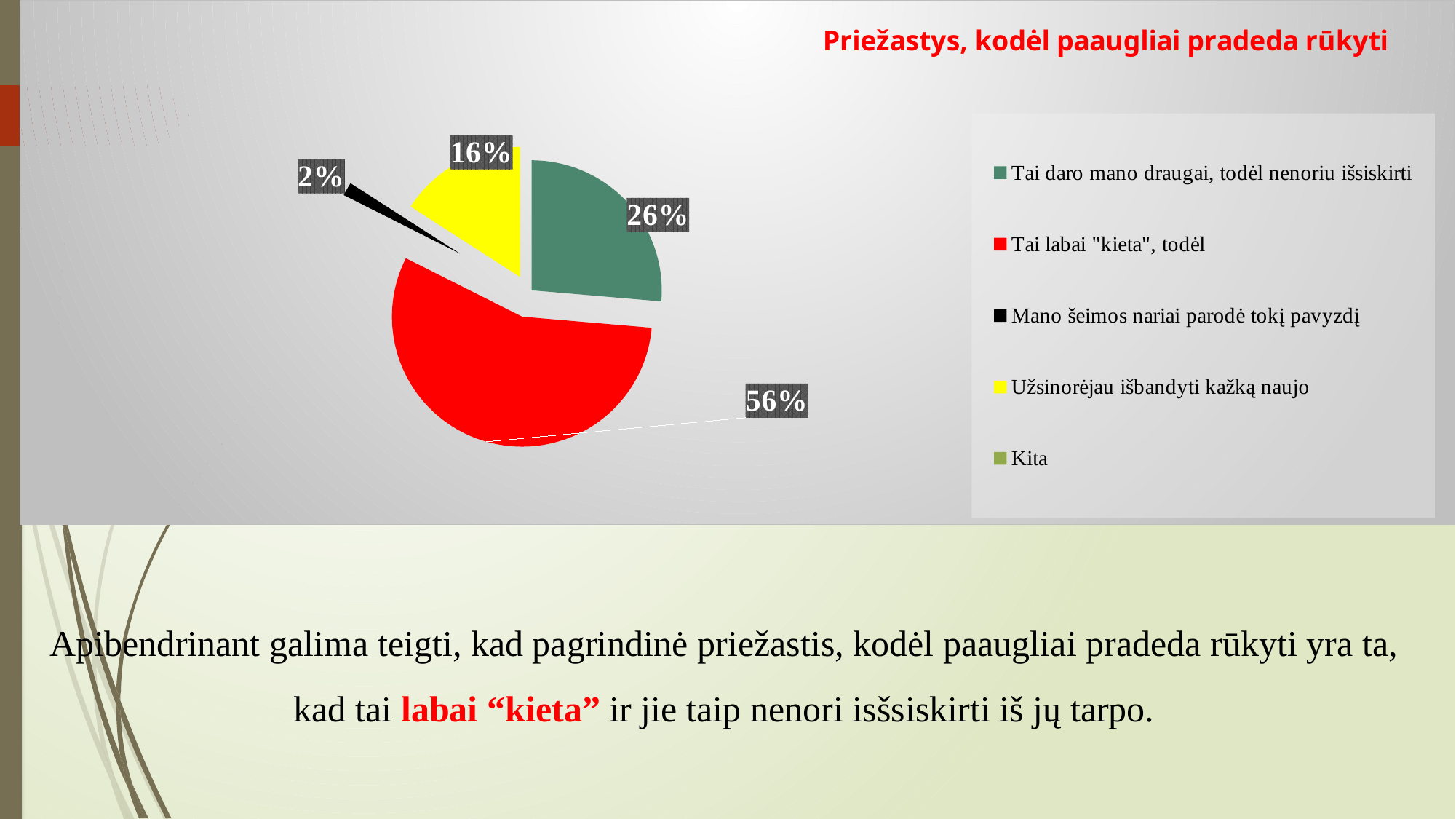
Which category has the largest slice of the pie? Tai labai "kieta", todėl Which is larger: the 'Užsinorėjau išbandyti kažką naujo' slice or the 'Tai daro mano draugai, todėl nenoriu išsiskirti' slice? Tai daro mano draugai, todėl nenoriu išsiskirti What is the difference in percentage points between the 'Tai labai "kieta", todėl' slice and the 'Tai daro mano draugai, todėl nenoriu išsiskirti' slice? 30% What colour is the slice for 'Užsinorėjau išbandyti kažką naujo'? yellow How many entries does the legend list? 5 What kind of chart is shown on the slide? pie chart What share of the pie does the slice 'Tai daro mano draugai, todėl nenoriu išsiskirti' represent? 26% What is the title of the chart? Priežastys, kodėl paaugliai pradeda rūkyti What share of the pie does the slice 'Tai labai "kieta", todėl' represent? 56% What share of the pie does the slice 'Užsinorėjau išbandyti kažką naujo' represent? 16% Which labelled slice of the pie is the smallest? Mano šeimos nariai parodė tokį pavyzdį